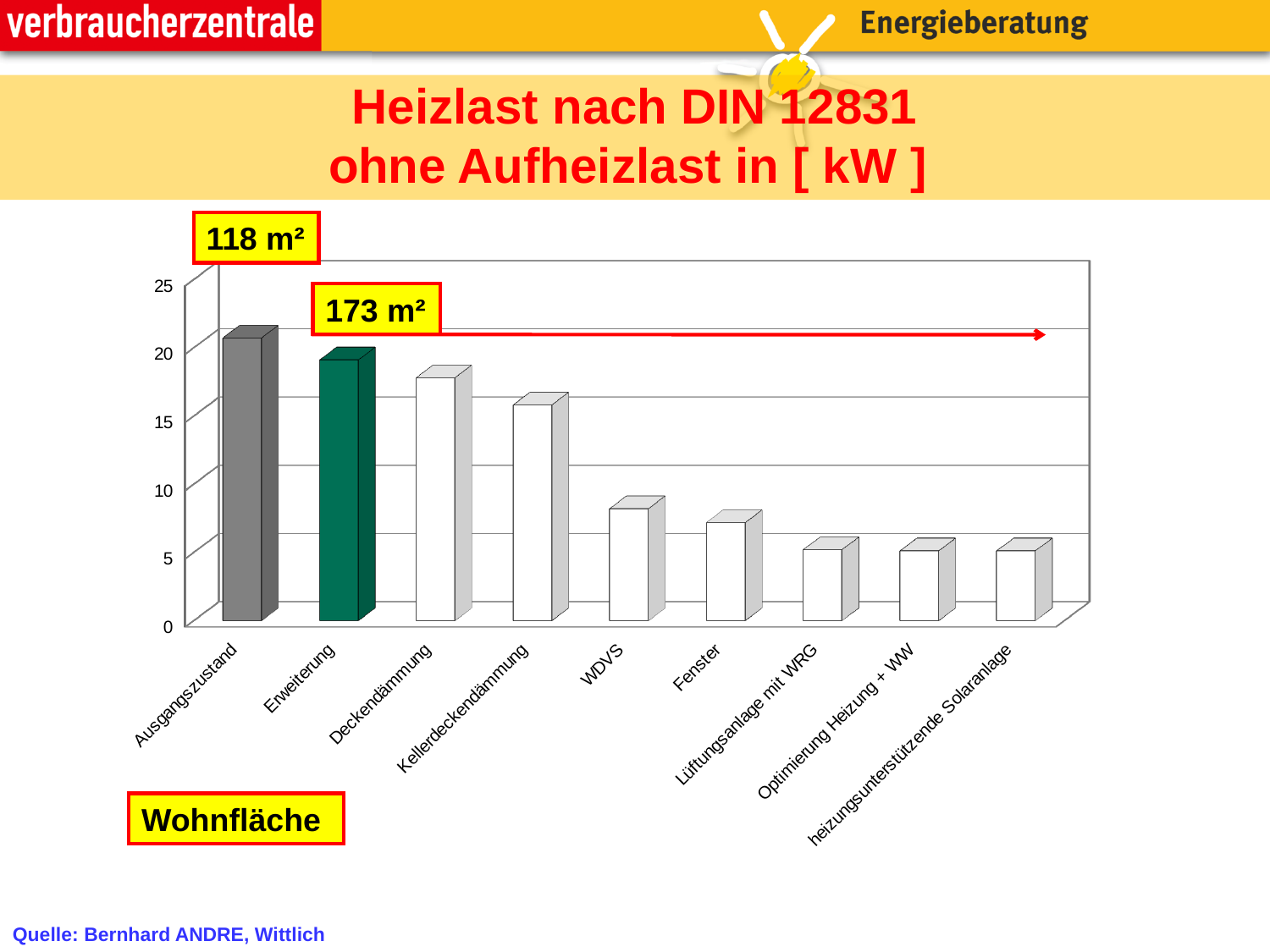
Which is larger, the value for Deckendämmung or the value for Fenster? Deckendämmung Is the value for Deckendämmung greater or less than 15? greater Do the values rise or fall from left to right along the x axis? fall Which category has the highest value in the chart? Ausgangszustand Is the value for Fenster greater or less than 10? less Is the value for WDVS greater or less than 10? less What is the title of the chart? Heizlast nach DIN 12831 ohne Aufheizlast in [ kW ] How many categories are plotted along the x axis of the chart? 9 What kind of chart is shown on the slide? bar chart